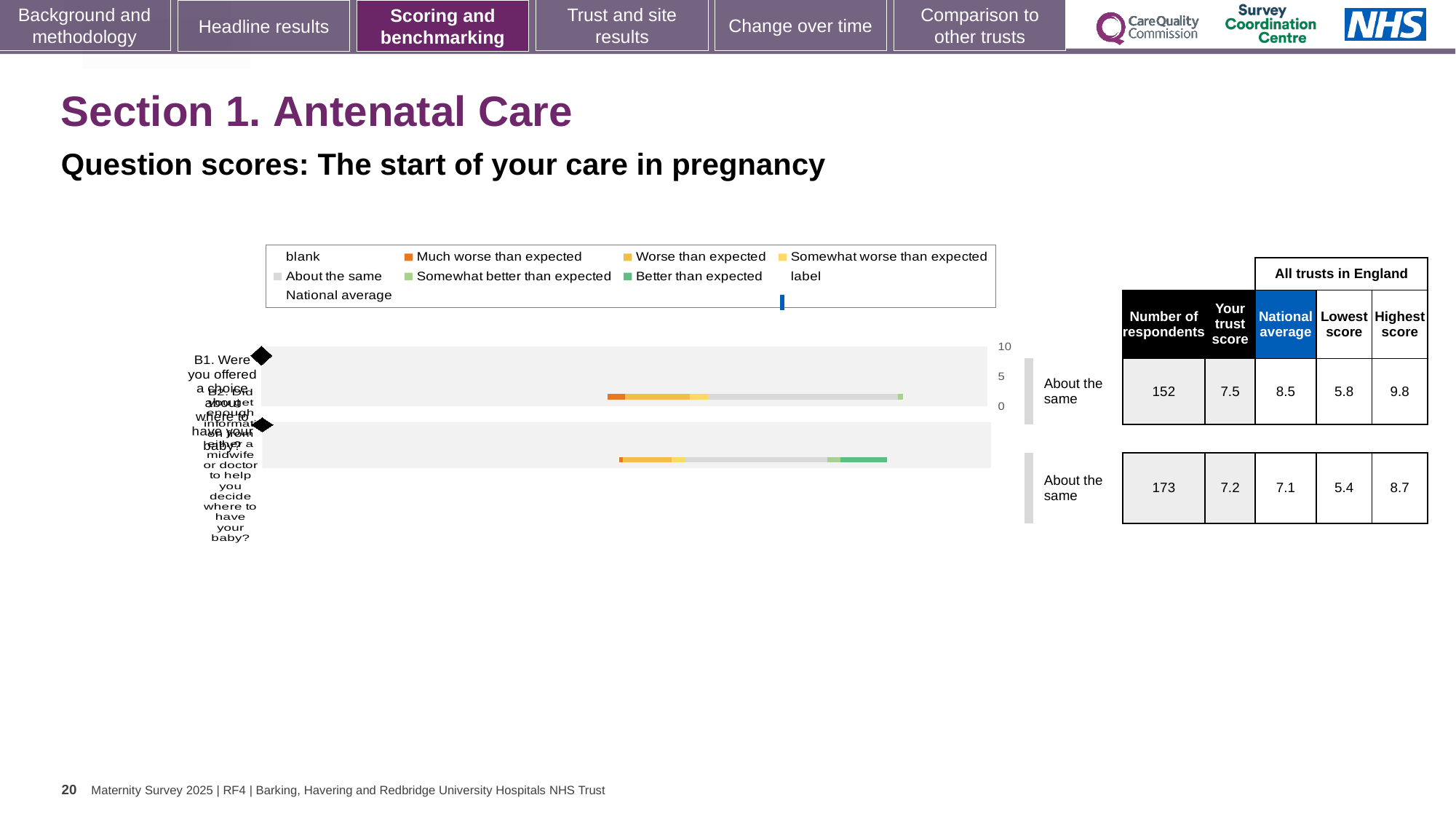
What benchmark category is the trust's result for question B1 placed in? About the same What is the national average score for question B2? 7.1 For question B2, is the trust's score higher or lower than the national average? higher How many questions are plotted in the chart? 2 By how much does the national average for B1 exceed the trust's score for B1? 1.0 How many respondents answered question B1? 152 What is the highest score across all trusts in England for question B2? 8.7 What is the 'Your trust score' for question B1 (Were you offered a choice about where to have your baby?)? 7.5 What is the difference between the highest and lowest trust scores in England for question B1? 4.0 Which question had more respondents, B1 or B2? B2 What is the lowest score across all trusts in England for question B1? 5.8 What kind of chart is shown on the slide? bar chart